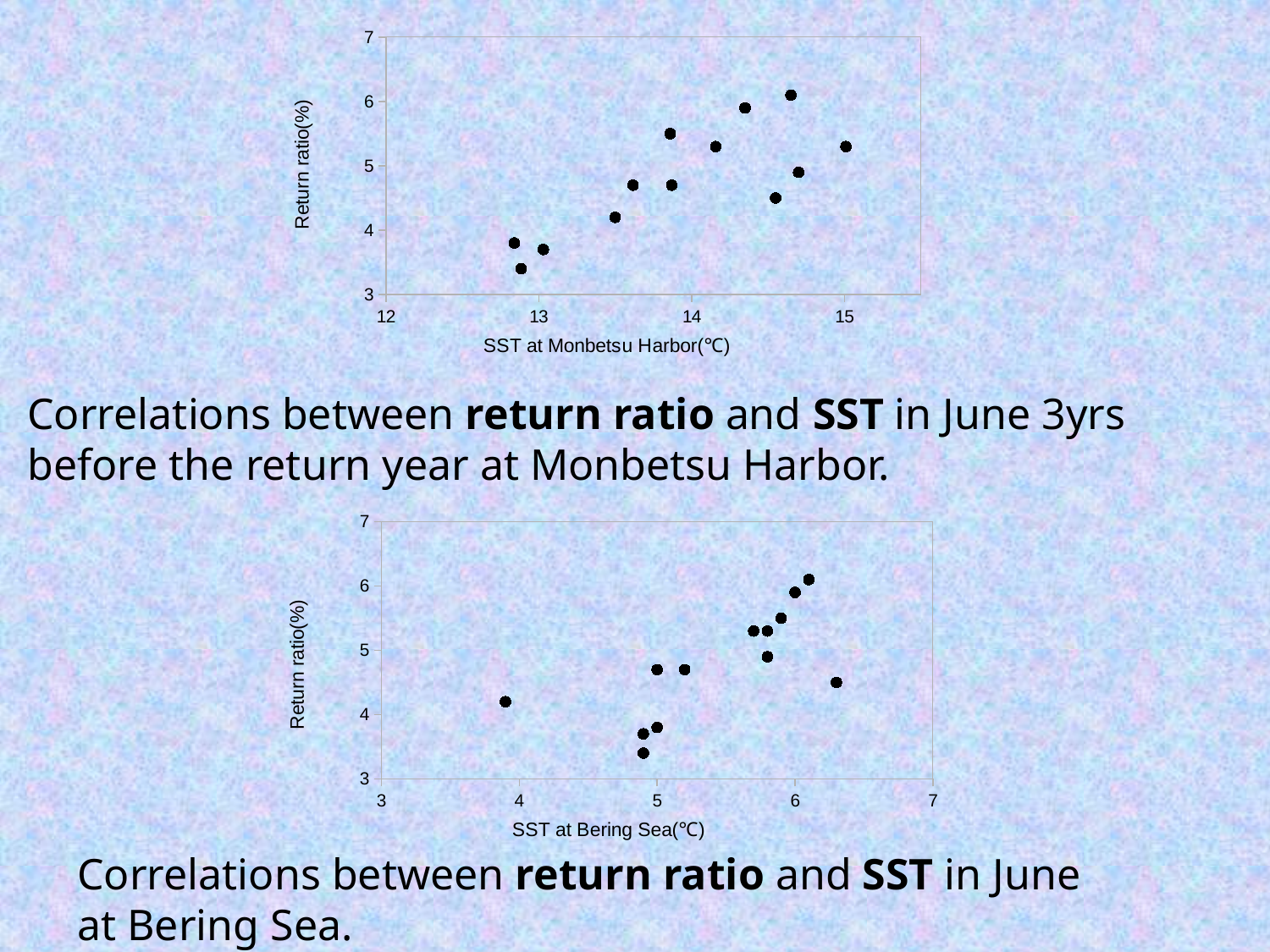
In the top chart (Monbetsu Harbor), is the return ratio of the lowest point greater or less than 4? less In the bottom chart (Bering Sea), is the return ratio of the point with the highest SST (near 6.3℃) greater or less than 5? less In the top chart (Monbetsu Harbor), does the return ratio generally rise or fall as SST increases? rise What kind of chart is the bottom chart, titled 'SST at Bering Sea'? scatter plot In the bottom chart (Bering Sea), is the return ratio of the highest point greater or less than 5? greater In the bottom chart (Bering Sea), what is the label of the x axis? SST at Bering Sea(℃) In the top chart (Monbetsu Harbor), what is the maximum value shown on the x axis? 15 In the bottom chart (Bering Sea), does the return ratio generally rise or fall as SST increases? rise In the top chart (Monbetsu Harbor), what is the label of the y axis? Return ratio(%) What kind of chart is the top chart, titled 'SST at Monbetsu Harbor'? scatter plot